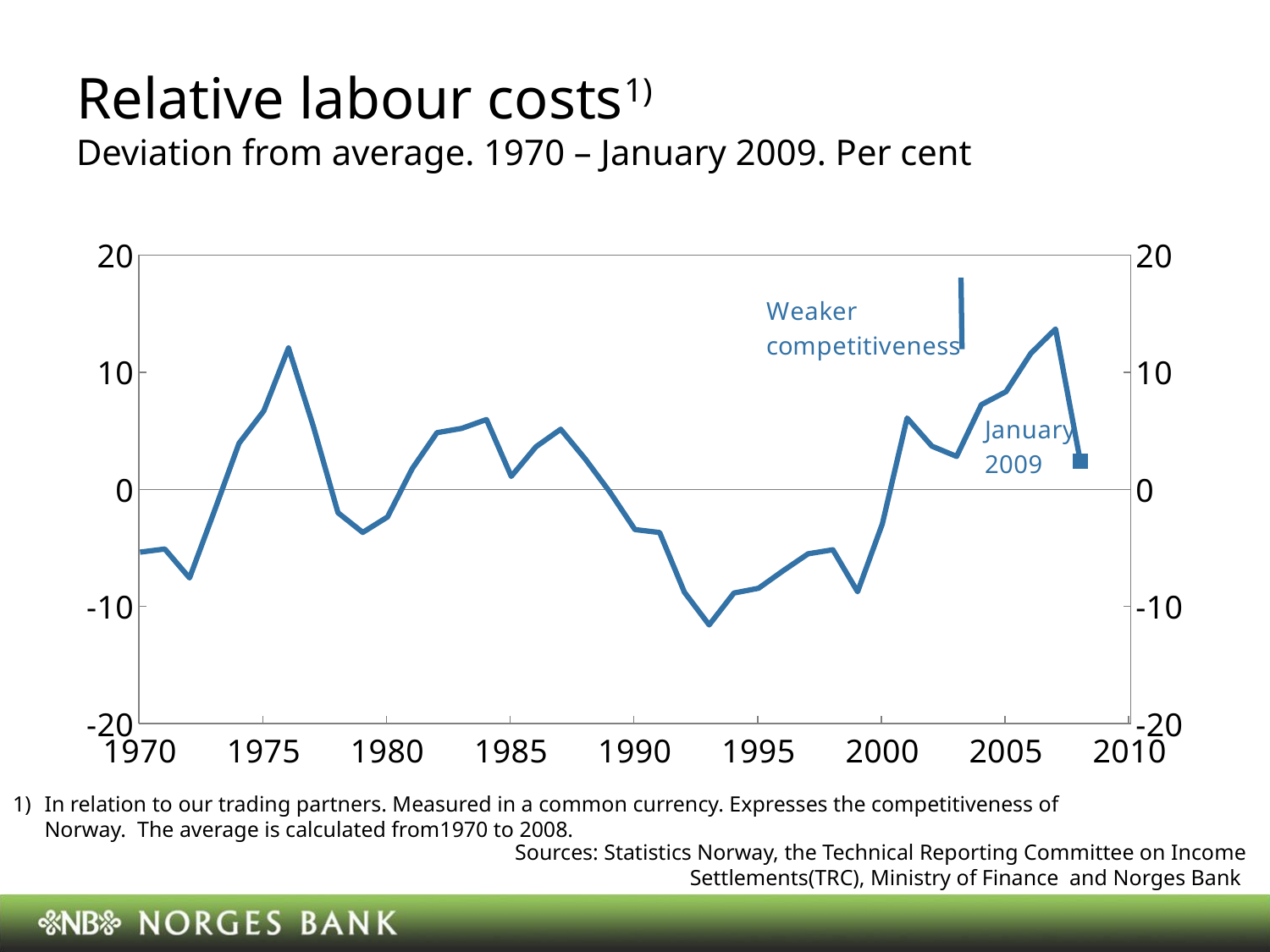
Is the value for 1970 greater or less than 0? less What does the annotation with the upward arrow on the chart say? Weaker competitiveness Is the value for 1999 greater or less than -5? less Do the values rise or fall between 2007 and January 2009? fall Is the value for 1972 greater or less than -5? less In which year does the line reach its lowest point? 1993 Do the values rise or fall between 1993 and 1998? rise What kind of chart is shown on the slide? Line chart How many series are plotted on the chart? 1